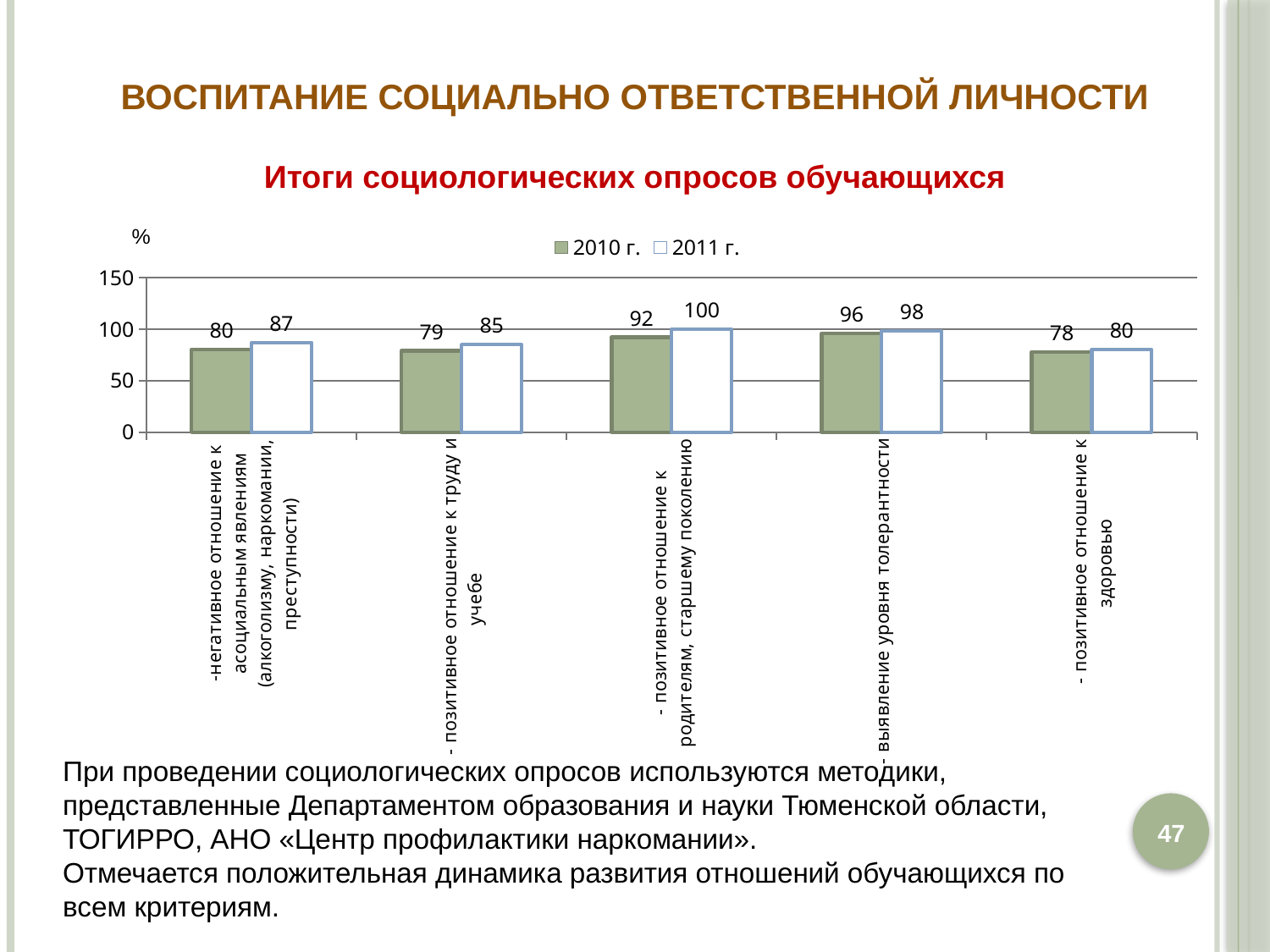
How many series does the legend list? 2 What kind of chart is shown on the slide? bar chart Which category has the lowest 2011 г. value? позитивное отношение к здоровью What is the 2011 г. value for "выявление уровня толерантности"? 98 What are the two series named in the legend? 2010 г. and 2011 г. How many categories are shown on the x axis? 5 Which category has the highest 2010 г. value? выявление уровня толерантности What is the 2010 г. value for "позитивное отношение к труду и учебе"? 79 Which is larger for "позитивное отношение к здоровью": the 2010 г. value or the 2011 г. value? 2011 г. What is the difference between the 2011 г. and 2010 г. values for "негативное отношение к асоциальным явлениям"? 7 Is the 2010 г. value for "позитивное отношение к родителям, старшему поколению" greater or less than 50? greater What is the 2011 г. value for "позитивное отношение к родителям, старшему поколению"? 100